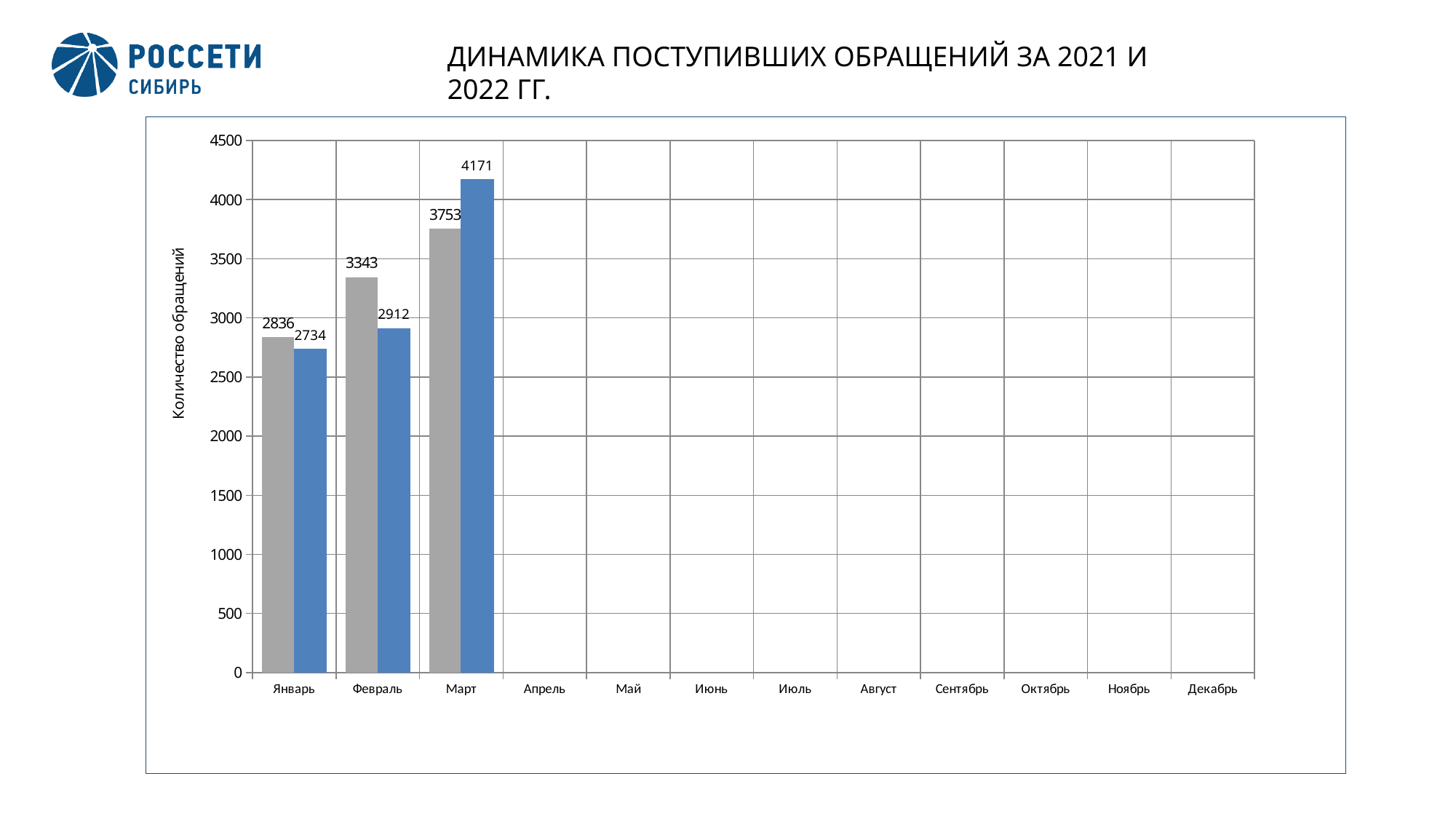
What is the value of the gray bar for Январь? 2836 What is the value of the blue bar for Февраль? 2912 What is the difference between the gray bar and the blue bar for Февраль? 431 For Январь, which bar is larger, the gray one or the blue one? The gray one What kind of chart is shown on the slide? Bar chart Which bar has the highest value on the chart? The blue bar for Март (4171) How many month categories are shown on the x axis? 12 Is the value of the gray bar for Март greater or less than 3500? greater What is the difference between the blue bar and the gray bar for Март? 418 What is the value of the blue bar for Март? 4171 Which bar has the lowest value on the chart? The blue bar for Январь (2734) What is the label of the vertical axis? Количество обращений